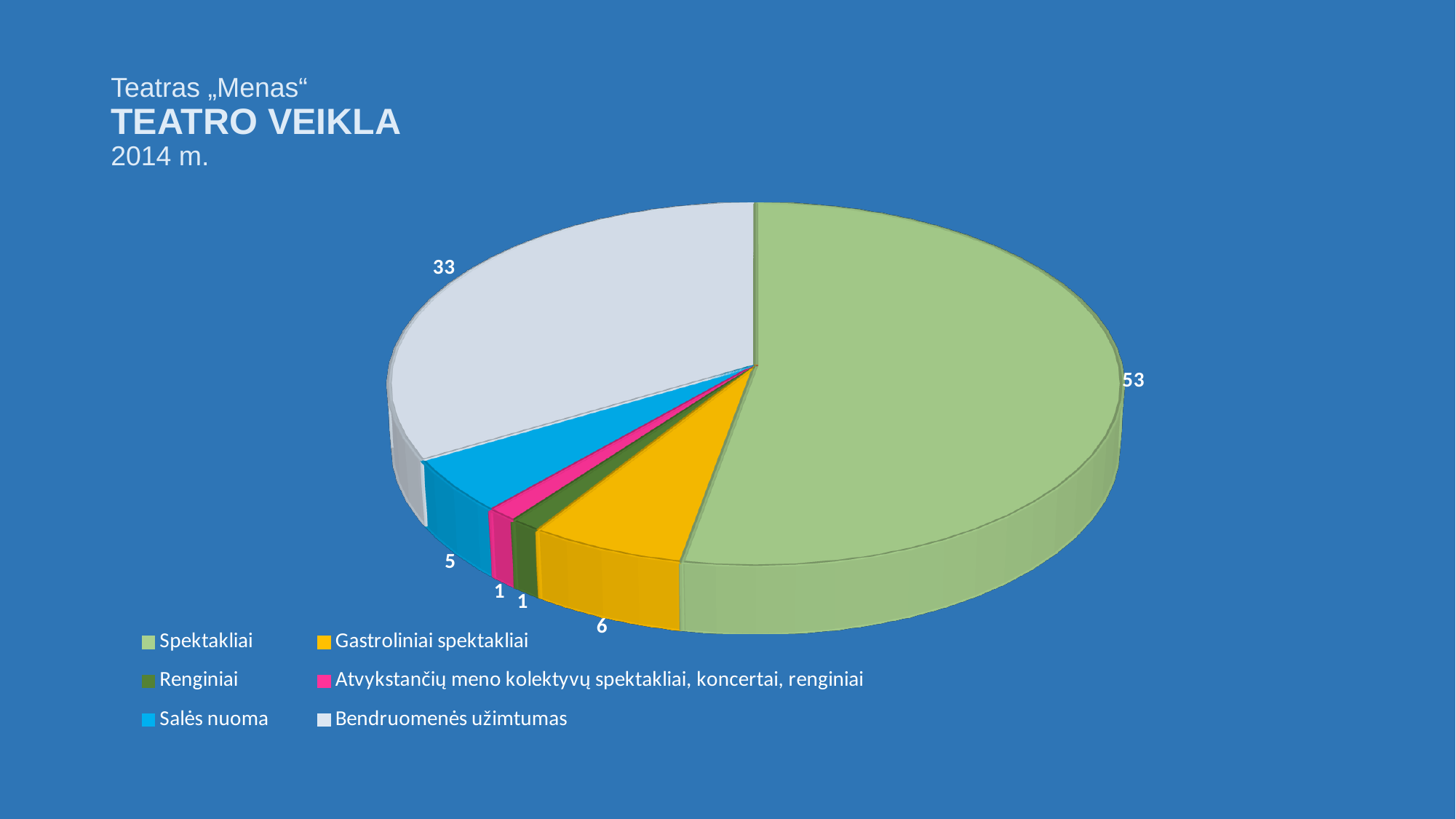
What is the difference between the values for Spektakliai and Bendruomenės užimtumas? 20 What is the value for Salės nuoma? 5 Which is larger, the value for Gastroliniai spektakliai or the value for Salės nuoma? Gastroliniai spektakliai What is the value for Bendruomenės užimtumas? 33 What kind of chart is shown on the slide? pie chart What is the total of all the values shown in the pie chart? 99 What colour is the slice for Atvykstančių meno kolektyvų spektakliai, koncertai, renginiai? pink What is the value for Gastroliniai spektakliai? 6 What is the value for Renginiai? 1 How many categories does the pie chart have? 6 Which category has the largest slice of the pie? Spektakliai What is the value for Spektakliai? 53